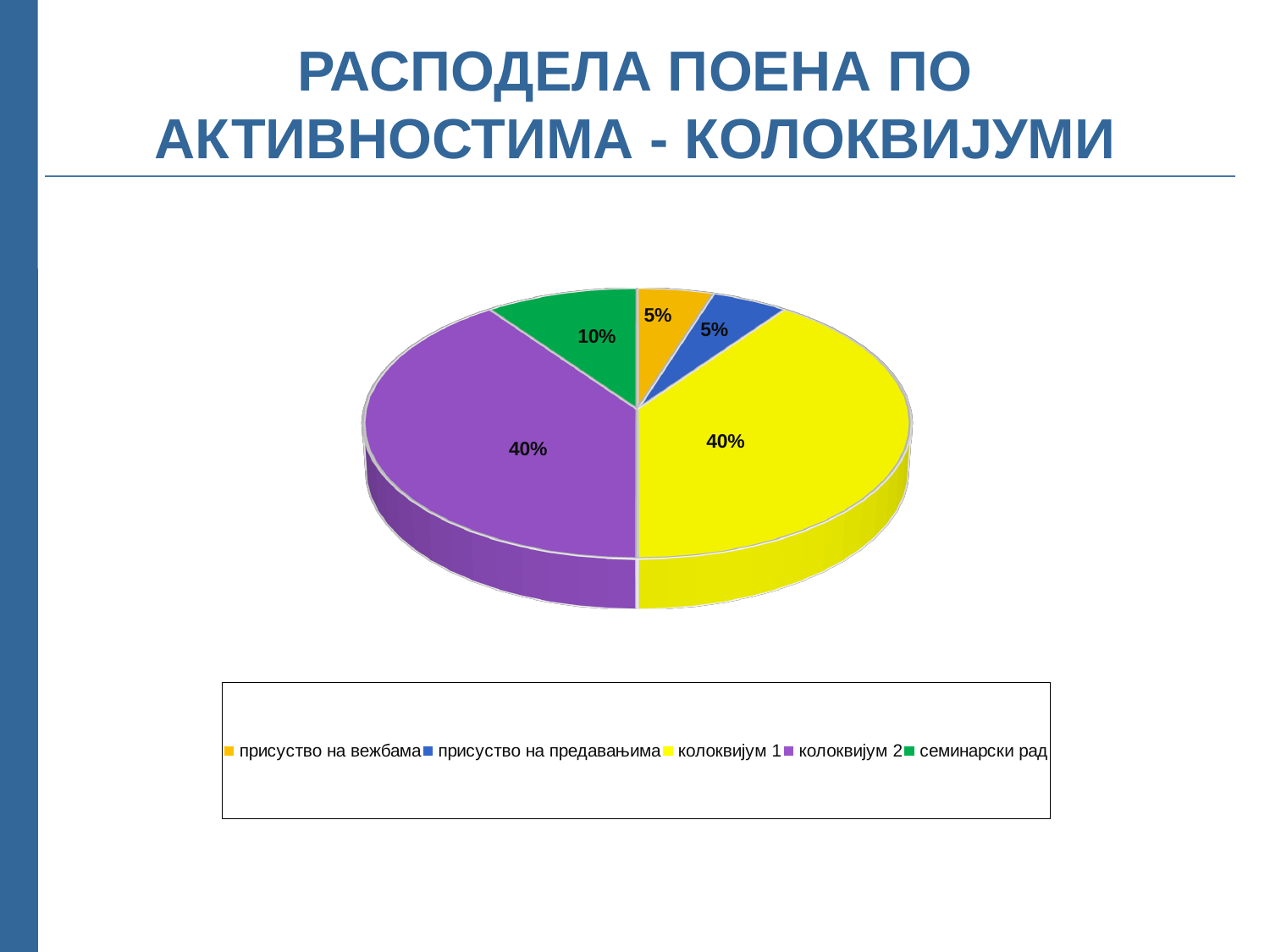
What percentage is shown for присуство на вежбама? 5% What is the difference in percentage points between колоквијум 1 and семинарски рад? 30 Which is larger, the share for колоквијум 2 or the share for семинарски рад? колоквијум 2 What share of points does семинарски рад account for? 10% What percentage is shown for колоквијум 2? 40% What share of points does колоквијум 1 account for? 40% What percentage is shown for присуство на предавањима? 5% What is the difference in percentage points between семинарски рад and присуство на предавањима? 5 Which is larger, the share for семинарски рад or the share for присуство на вежбама? семинарски рад Which colour represents колоквијум 1 in the legend? Yellow What kind of chart is shown on the slide? Pie chart How many slices does the pie chart have? 5